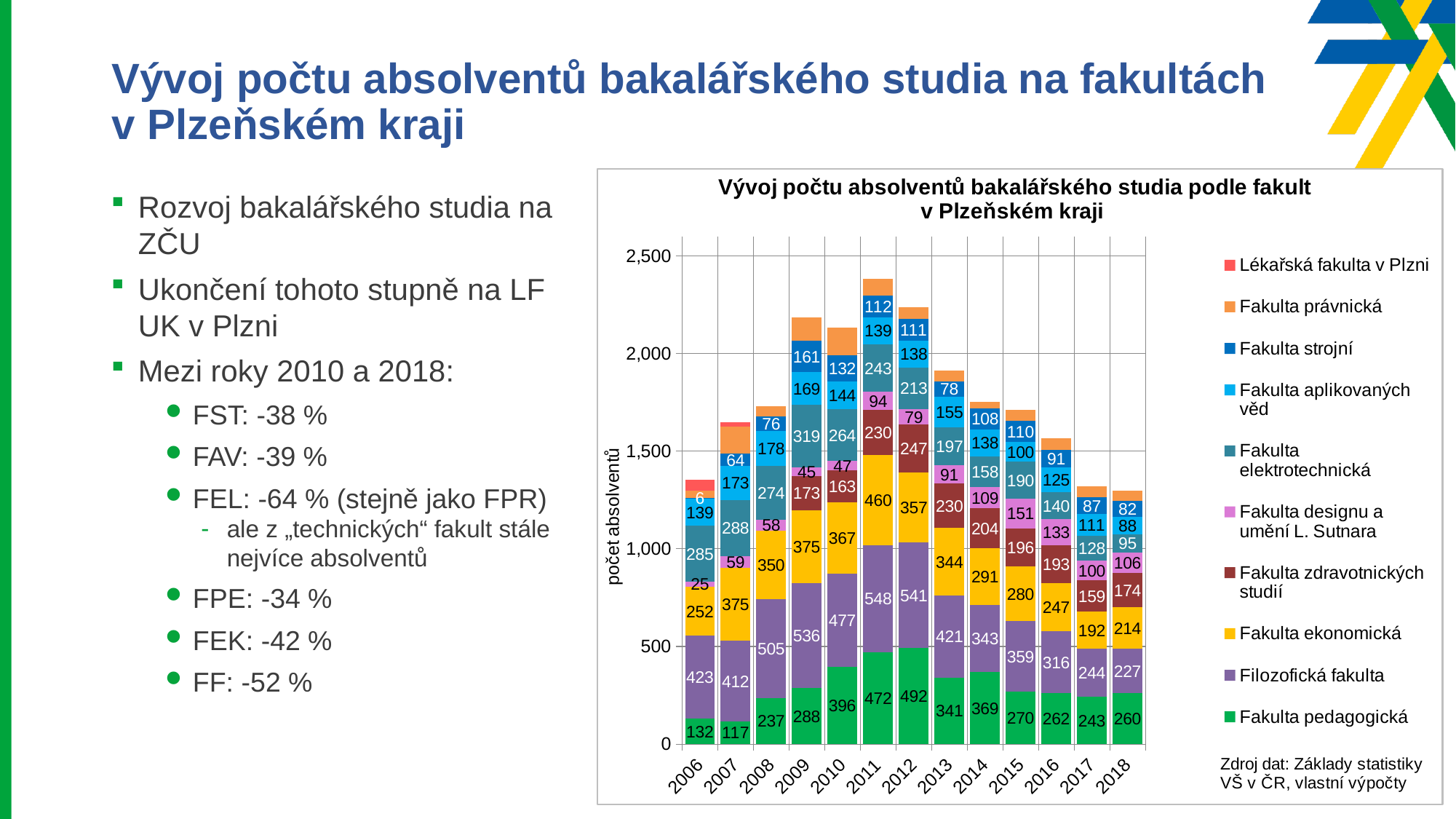
Do the Fakulta ekonomická values rise or fall from 2011 to 2017? fall What is the value for Fakulta zdravotnických studií in 2013? 230 In which year is the value for Fakulta pedagogická lowest? 2007 What is the value for Fakulta elektrotechnická in 2009? 319 Is the total height of the 2011 bar greater or less than 2,000? greater Which is larger, the Fakulta ekonomická value in 2010 or in 2012? 2010 What is the difference between the Fakulta pedagogická values in 2012 and 2006? 360 In which year is the value for Filozofická fakulta highest? 2011 How many years are shown on the x axis? 13 How many series does the legend list? 10 What is the value for Filozofická fakulta in 2012? 541 What is the value for Fakulta pedagogická in 2011? 472